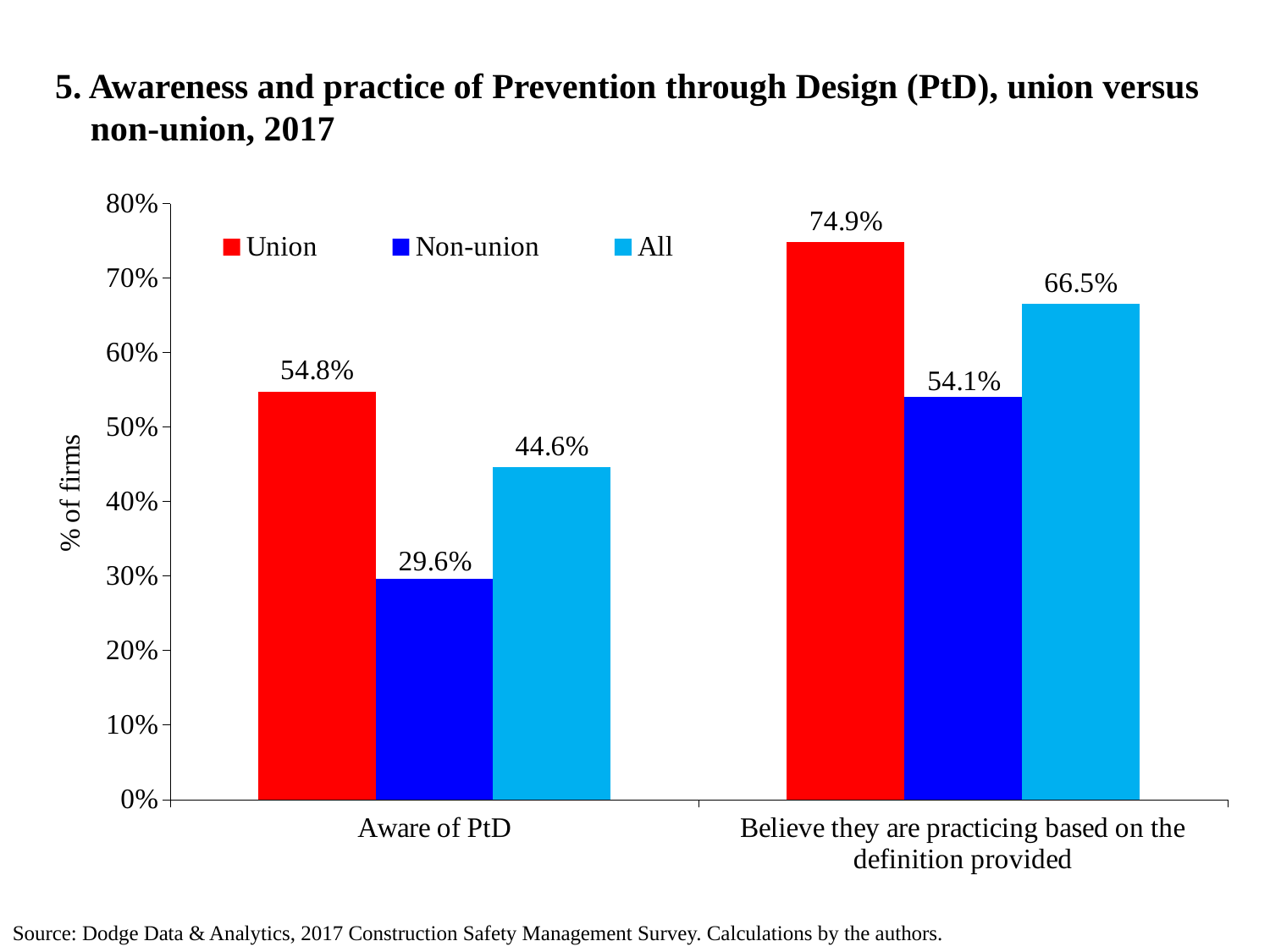
What is the difference between the Union and All values for 'Believe they are practicing based on the definition provided'? 8.4 percentage points What is the value for All firms in the 'Aware of PtD' category? 44.6% What percentage of Union firms are aware of PtD? 54.8% Which series has the highest value in the 'Believe they are practicing based on the definition provided' category? Union What is the difference between the Union and Non-union values for 'Aware of PtD'? 25.2 percentage points What percentage of Non-union firms believe they are practicing PtD based on the definition provided? 54.1% What colour represents the Non-union series? Blue Is the Union value for 'Believe they are practicing based on the definition provided' greater or less than 70%? greater What kind of chart is shown on the slide? Bar chart Which is larger: the Non-union value for 'Aware of PtD' or the Non-union value for 'Believe they are practicing based on the definition provided'? Believe they are practicing based on the definition provided Which series has the lowest value in the 'Aware of PtD' category? Non-union How many series does the legend list? 3